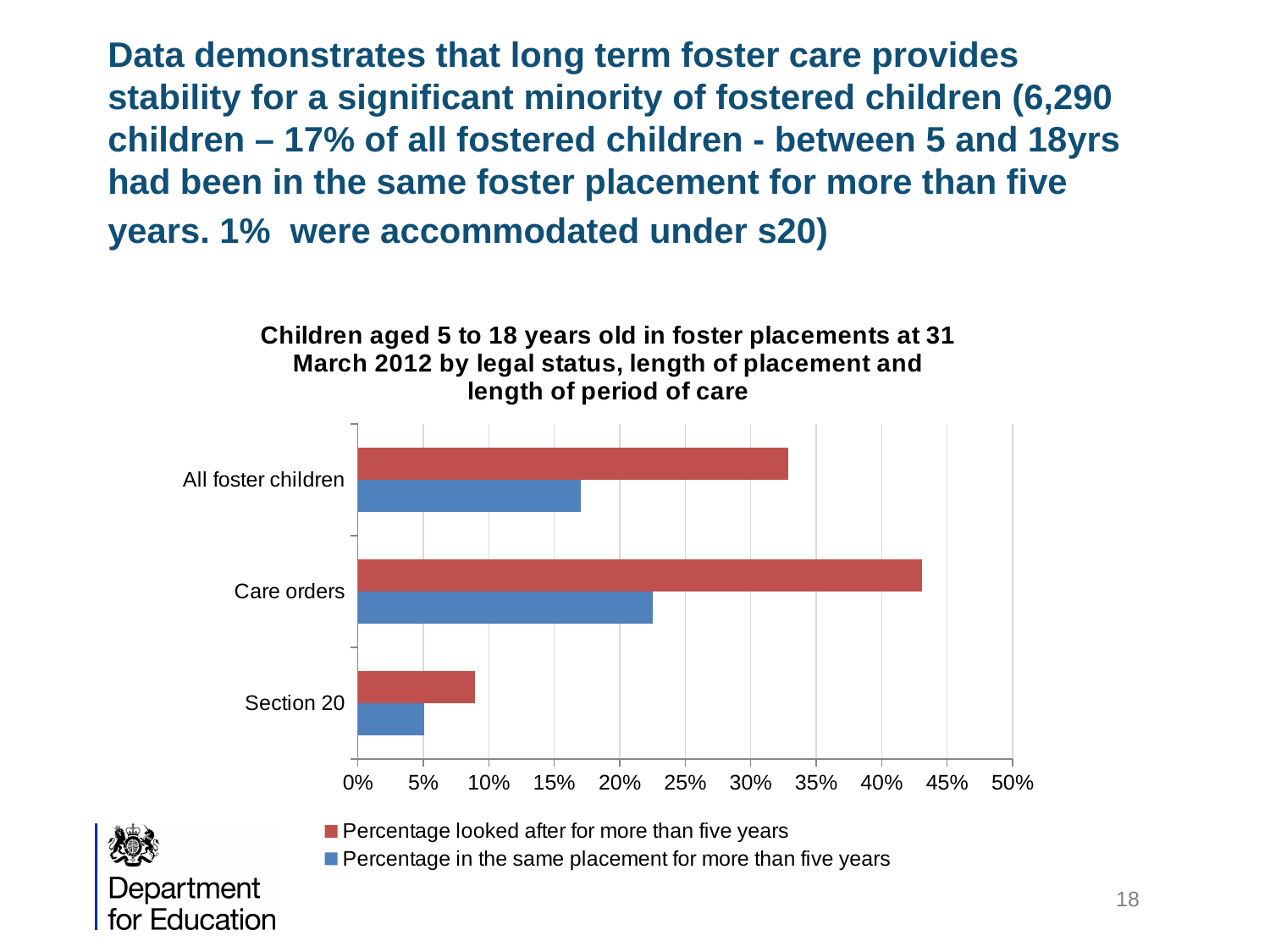
Is the value for 'Percentage looked after for more than five years' for Care orders greater or less than 40%? greater What kind of chart is shown on the slide? bar chart For Care orders, which is larger: 'Percentage looked after for more than five years' or 'Percentage in the same placement for more than five years'? Percentage looked after for more than five years What is the maximum value shown on the chart's horizontal axis? 50% How many series does the legend list? 2 Which category has the lowest value for 'Percentage in the same placement for more than five years'? Section 20 Is the value for 'Percentage in the same placement for more than five years' for Section 20 greater or less than 10%? less Is the value for 'Percentage in the same placement for more than five years' for Care orders greater or less than 20%? greater How many categories are shown on the chart's vertical axis? 3 Which category has the highest value for 'Percentage looked after for more than five years'? Care orders Which colour represents 'Percentage in the same placement for more than five years' in the legend? blue